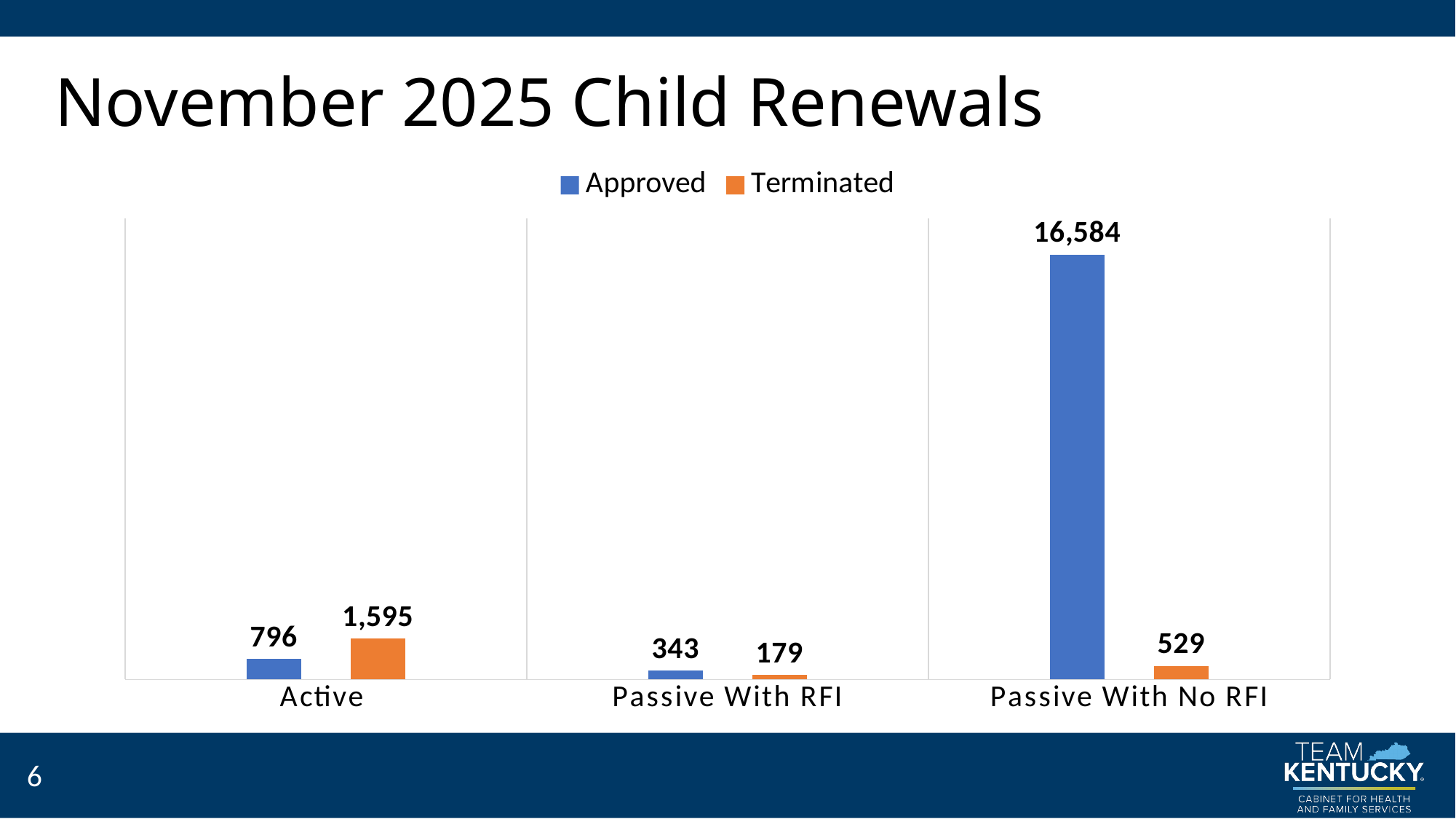
Which category has the highest Approved value? Passive With No RFI How many categories are shown on the x axis? 3 For Active, which is larger: Approved or Terminated? Terminated How many series does the legend list? 2 What is the Terminated value for Active? 1,595 What is the Approved value for Active? 796 What colour represents the Terminated series? Orange What is the Approved value for Passive With RFI? 343 What kind of chart is shown on the slide? Bar chart What is the difference between the Approved and Terminated values for Passive With No RFI? 16,055 Which category has the lowest Terminated value? Passive With RFI What is the Terminated value for Passive With No RFI? 529